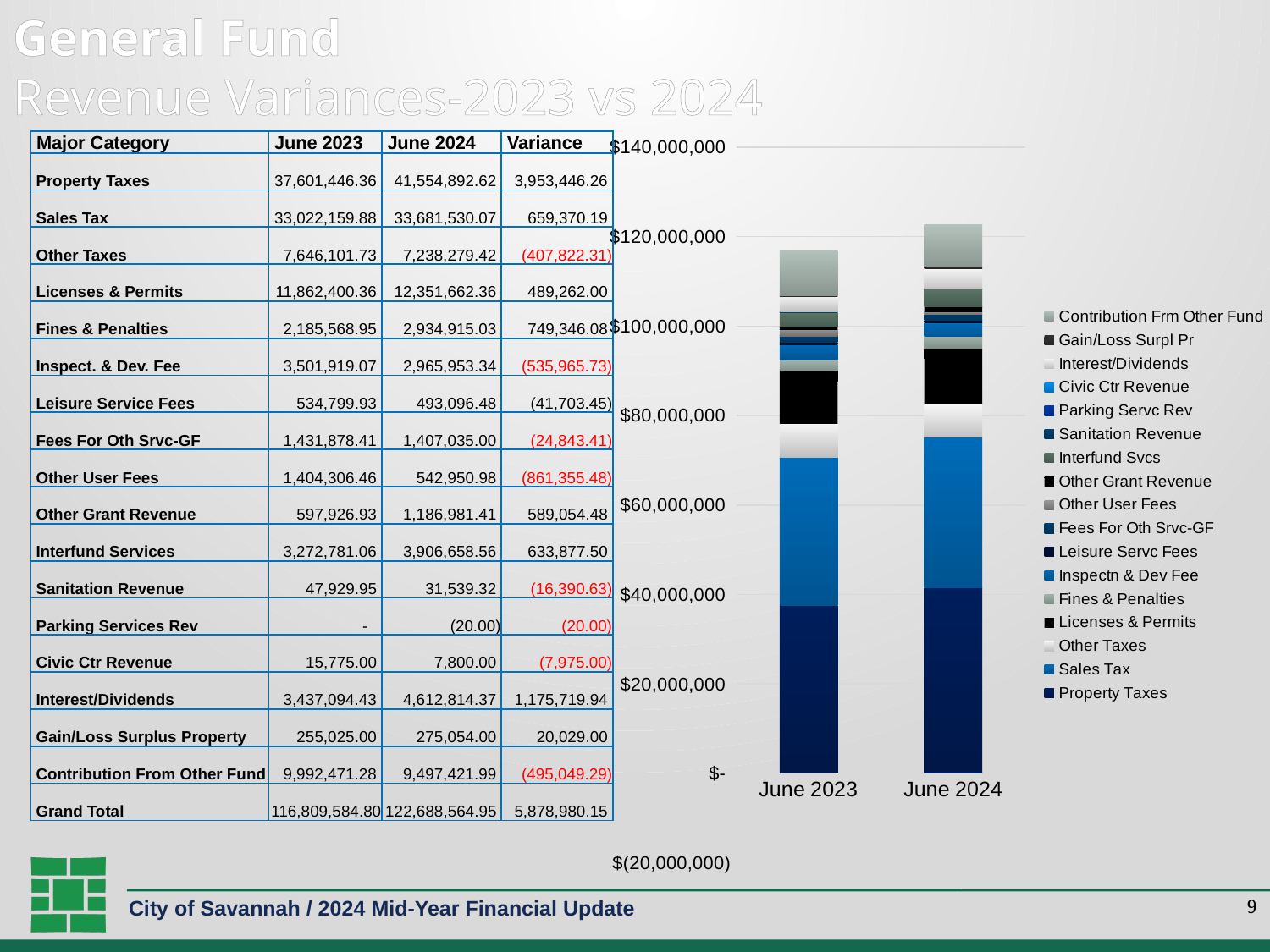
Which bar is taller overall, June 2023 or June 2024? June 2024 According to the table, what is the Property Taxes value for June 2024? 41,554,892.62 How many series does the chart legend list? 17 According to the table, what is the total of the June 2023 stacked bar (Grand Total)? 116,809,584.80 Is the total height of the June 2024 bar greater or less than $100,000,000? greater Which series is listed last (at the bottom) in the chart legend? Property Taxes How many bars (categories) are plotted on the x axis of the chart? 2 Which series forms the largest segment of the June 2024 bar? Property Taxes Do the total revenues rise or fall from June 2023 to June 2024? rise What kind of chart is shown on the slide? stacked bar chart Is the total height of the June 2023 bar greater or less than $120,000,000? less Is the total height of the June 2023 bar greater or less than $100,000,000? greater